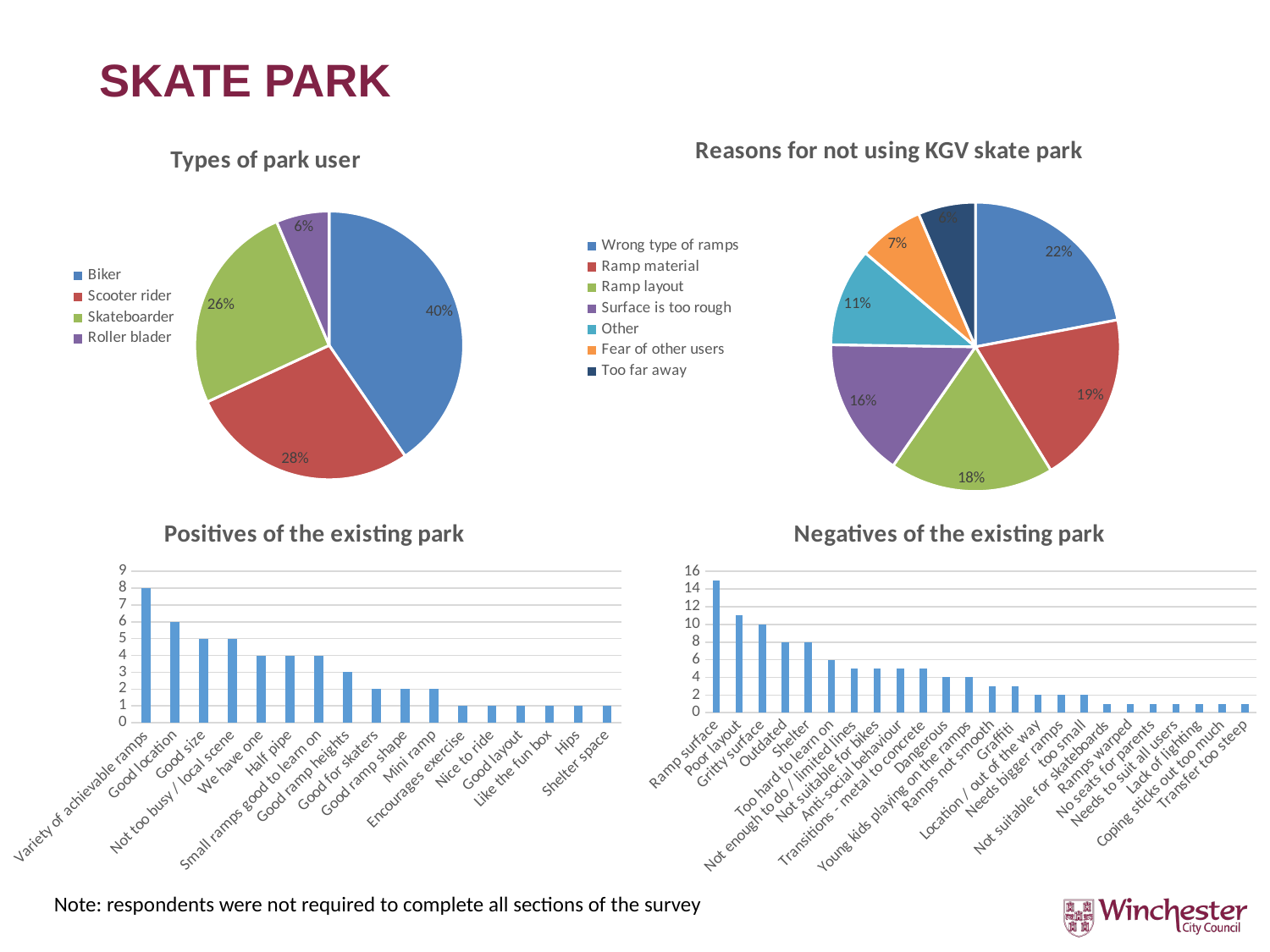
In the 'Types of park user' pie chart, what is the difference in percentage points between scooter riders and skateboarders? 2 In the 'Negatives of the existing park' chart, which is larger, 'Too hard to learn on' or 'Dangerous'? Too hard to learn on In the 'Types of park user' pie chart, which type of park user has the smallest share? Roller blader In the 'Negatives of the existing park' chart, is the value for 'Ramp surface' greater or less than 14? greater What kind of chart is 'Positives of the existing park'? Bar chart In the 'Reasons for not using KGV skate park' pie chart, which reason has the largest share? Wrong type of ramps In the 'Positives of the existing park' chart, what is the value for 'Variety of achievable ramps'? 8 How many entries does the legend of the 'Reasons for not using KGV skate park' chart list? 7 In the 'Positives of the existing park' chart, what is the value for 'Good ramp heights'? 3 In the 'Types of park user' pie chart, what percentage of park users are bikers? 40% In the 'Negatives of the existing park' chart, what is the value for 'Gritty surface'? 10 In the 'Reasons for not using KGV skate park' pie chart, what percentage is 'Ramp material'? 19%